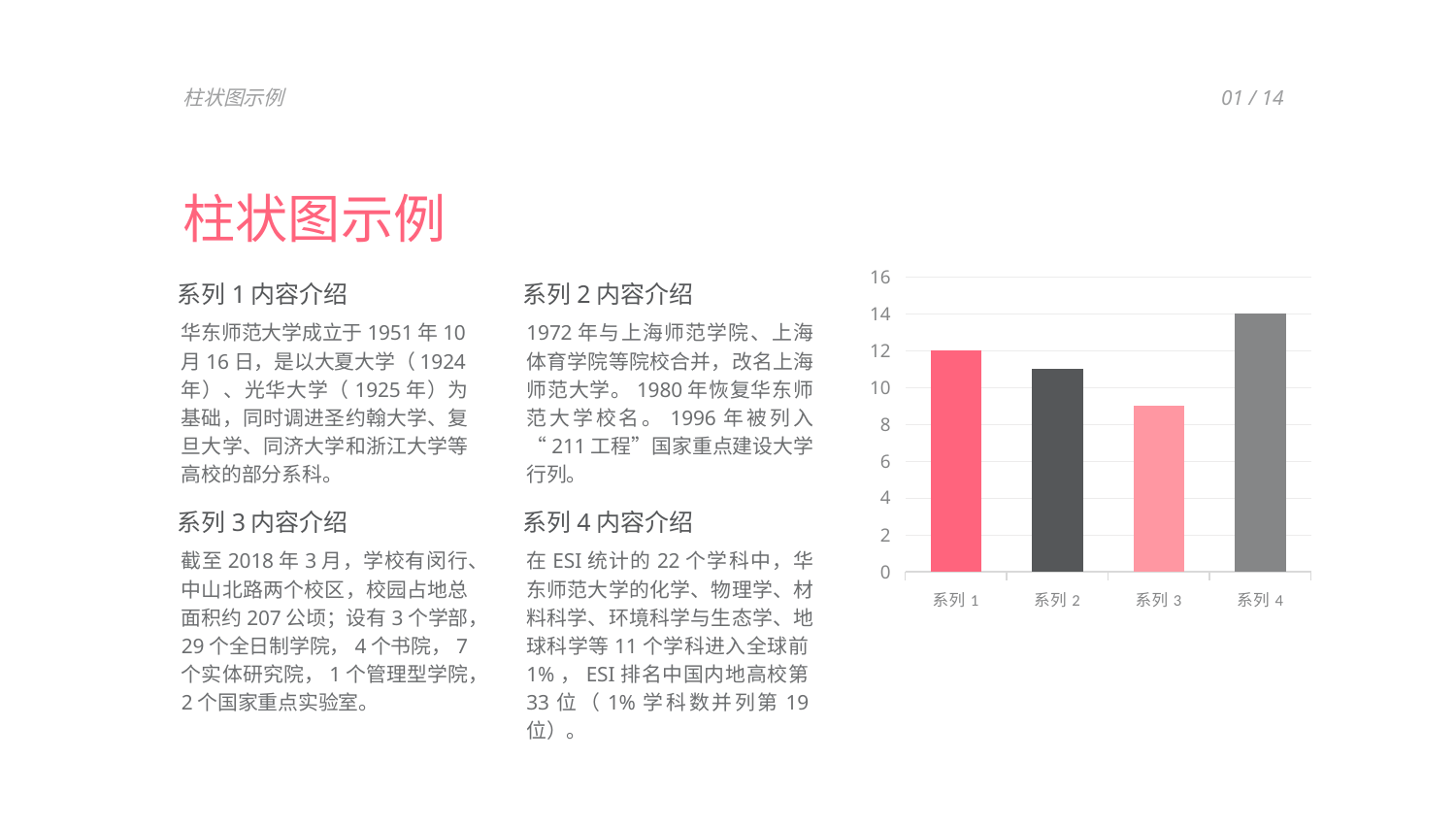
Which category has the lowest bar in the chart? 系列 3 What colour is the bar for 系列 1? pink Which category has the highest bar in the chart? 系列 4 What is the value for 系列 4 in the chart? 14 What is the value for 系列 1 in the chart? 12 Is the value for 系列 2 greater or less than 10? greater How many categories are plotted in the chart? 4 What is the highest value shown on the vertical axis of the chart? 16 What kind of chart is shown on the slide? bar chart Is the value for 系列 3 greater or less than 10? less Is the value for 系列 3 greater or less than 8? greater Which is larger, the value for 系列 4 or the value for 系列 3? 系列 4